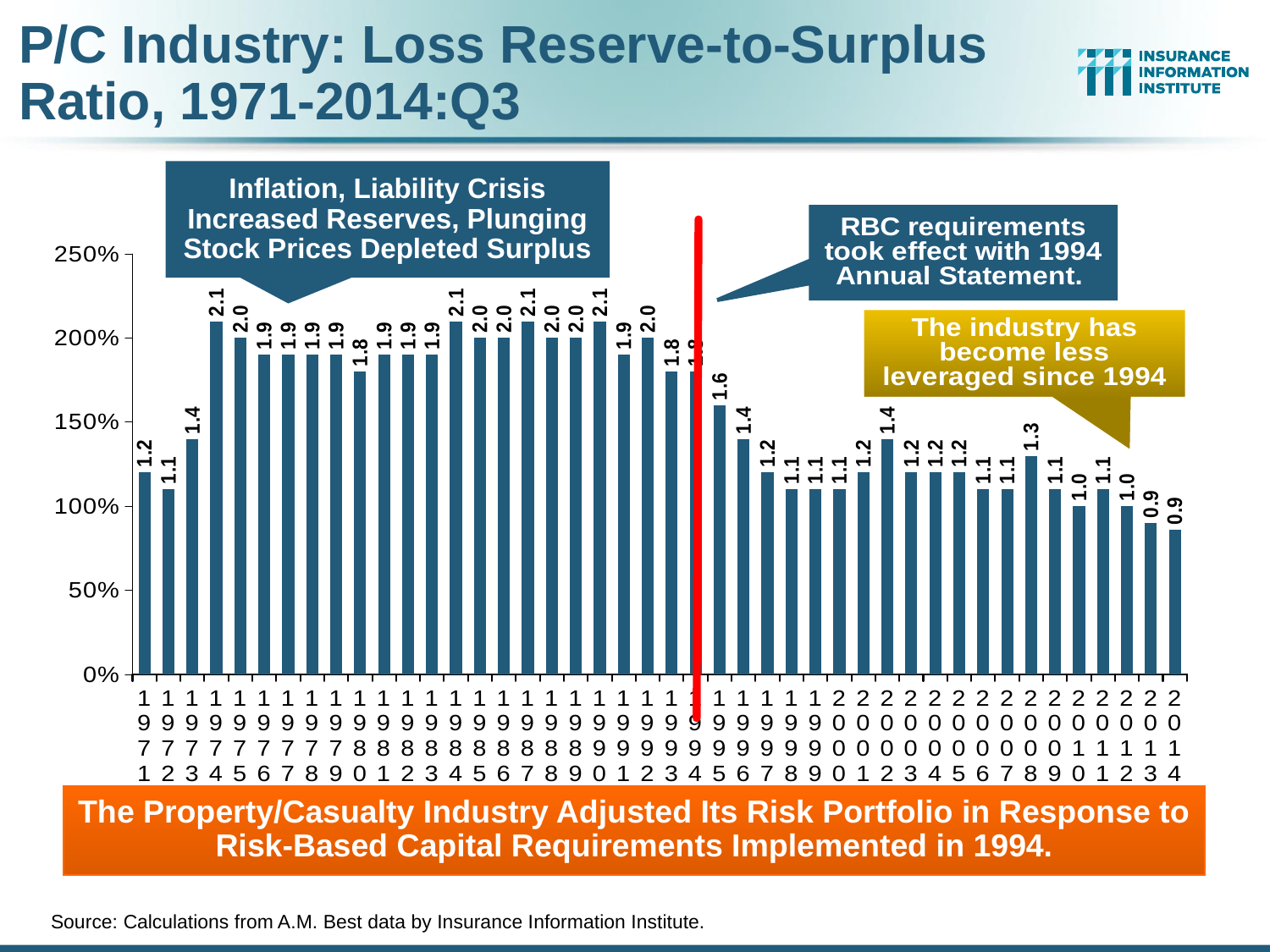
What is the difference between the values for 1974 and 2014? 1.2 How many years (bars) are shown on the chart? 44 Do the values generally rise or fall from 1995 to 2014? Fall What is the lowest value labeled on the chart? 0.9 What is the value shown for 1973? 1.4 What is the loss reserve-to-surplus ratio for 1995? 1.6 What is the value shown for 2008? 1.3 Is the value for 2010 greater or less than 150%? less Which year has the larger value, 1995 or 2002? 1995 What kind of chart is shown on the slide? Bar chart What is the value shown for 2014? 0.9 Is the value for 1980 greater or less than 150%? greater